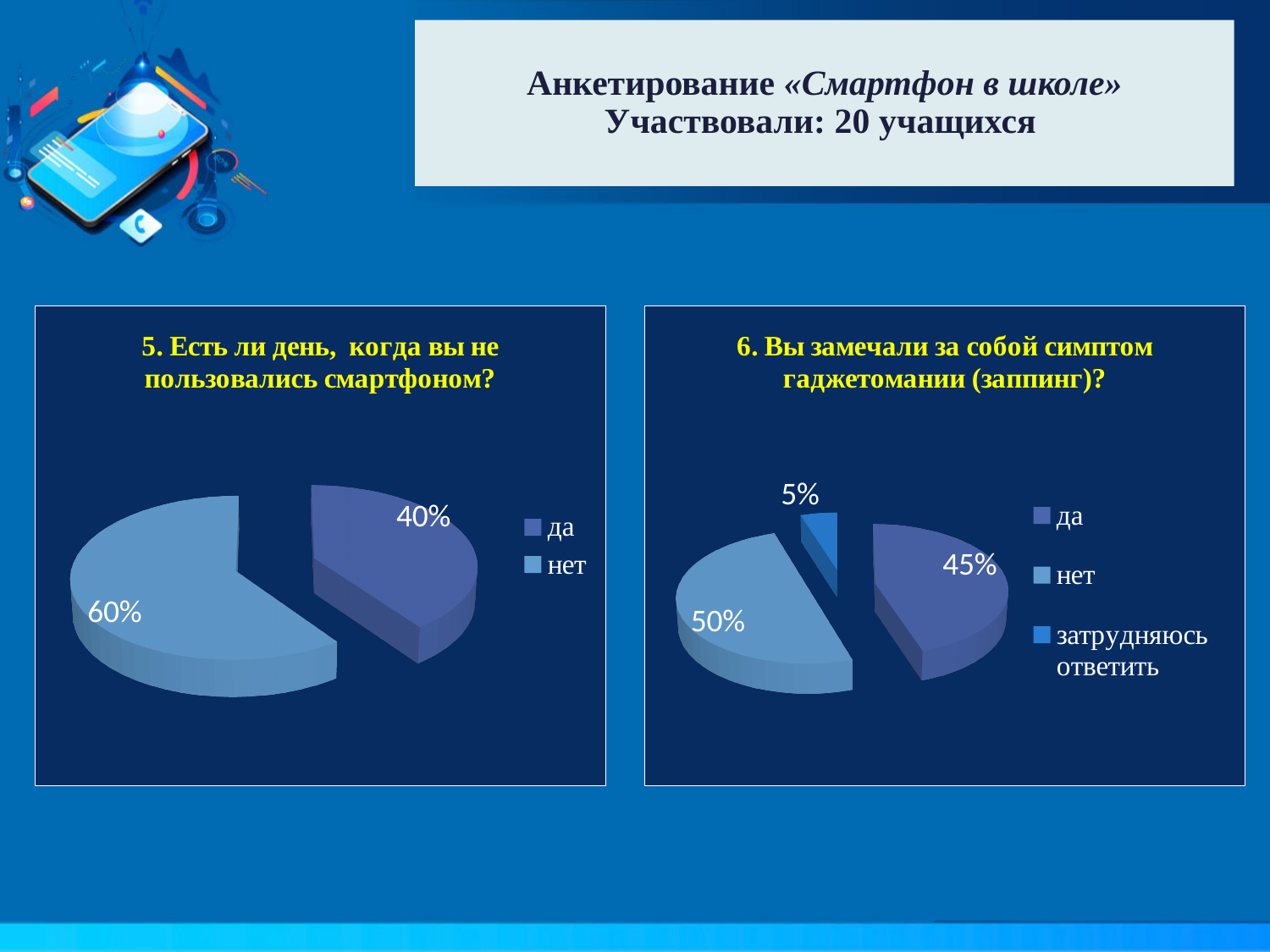
In the right chart (question 6), what share of respondents answered "да"? 45% In the right chart (question 6), what is the difference between the "нет" and "да" shares? 5% In the left chart (question 5), what share of respondents answered "нет"? 60% What type of chart is the left chart (question 5)? pie chart In the left chart (question 5), what is the difference between the "нет" and "да" shares? 20% In the left chart (question 5), what share of respondents answered "да"? 40% In the right chart (question 6), which answer has the largest share? нет How many slices does the right chart (question 6) have? 3 How many entries does the legend of the left chart (question 5) list? 2 In the right chart (question 6), what share of respondents answered "затрудняюсь ответить"? 5% In the right chart (question 6), which answer has the smallest share? затрудняюсь ответить In the left chart (question 5), which answer has the larger share? нет